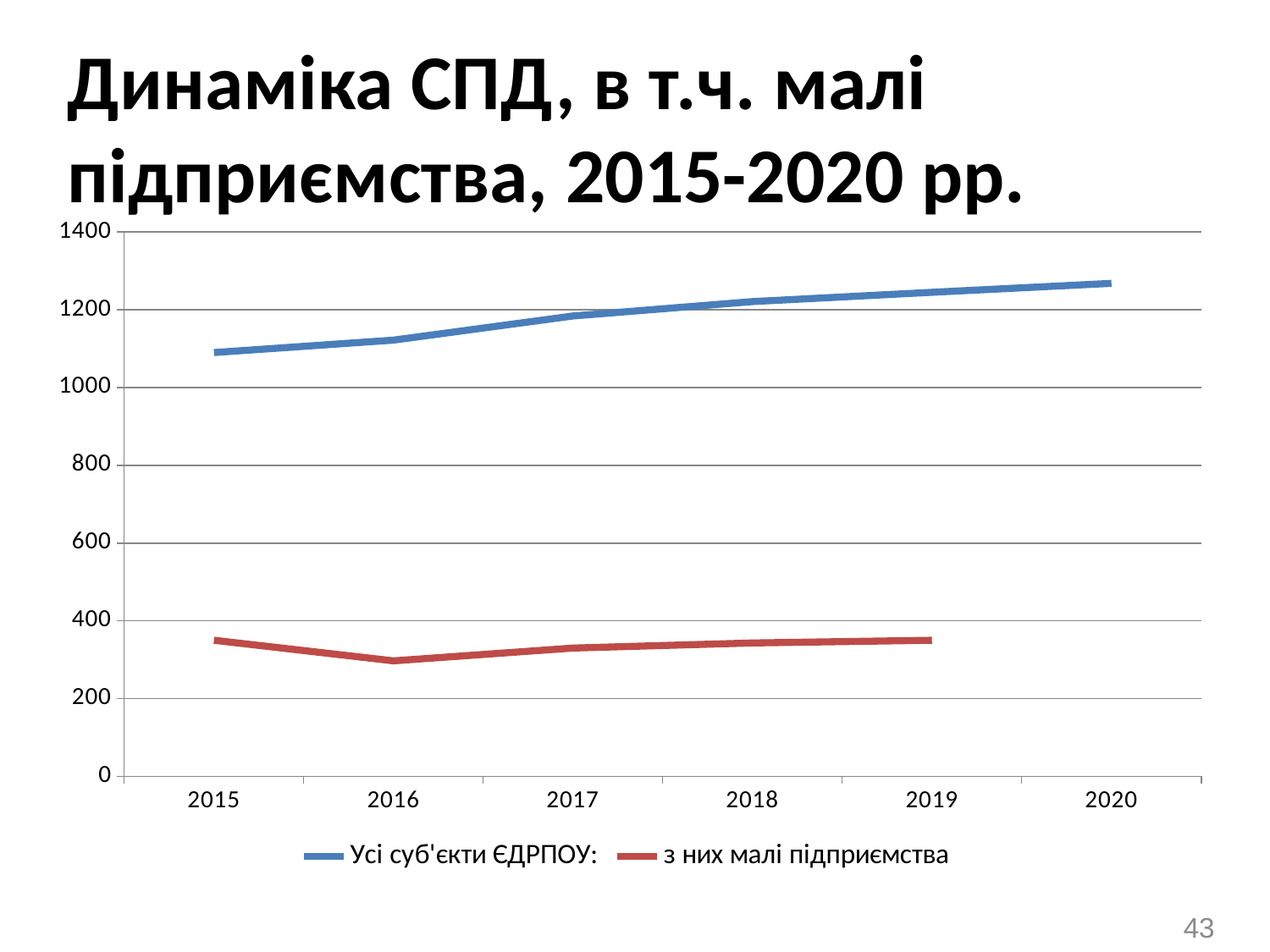
In which year is the value for 'Усі суб'єкти ЄДРПОУ' lowest? 2015 Is the value for 'з них малі підприємства' in 2016 greater or less than 400? less In which year is the value for 'з них малі підприємства' lowest? 2016 How many years are shown on the x axis? 6 What kind of chart is shown on the slide? line chart Which series has the larger value in 2018, 'Усі суб'єкти ЄДРПОУ' or 'з них малі підприємства'? Усі суб'єкти ЄДРПОУ How many series does the legend list? 2 In which year is the value for 'Усі суб'єкти ЄДРПОУ' highest? 2020 Does the value for 'Усі суб'єкти ЄДРПОУ' rise or fall from 2015 to 2020? rise Is the value for 'Усі суб'єкти ЄДРПОУ' in 2015 greater or less than 1000? greater Is the value for 'Усі суб'єкти ЄДРПОУ' in 2020 greater or less than 1200? greater What colour is the line for 'з них малі підприємства'? red